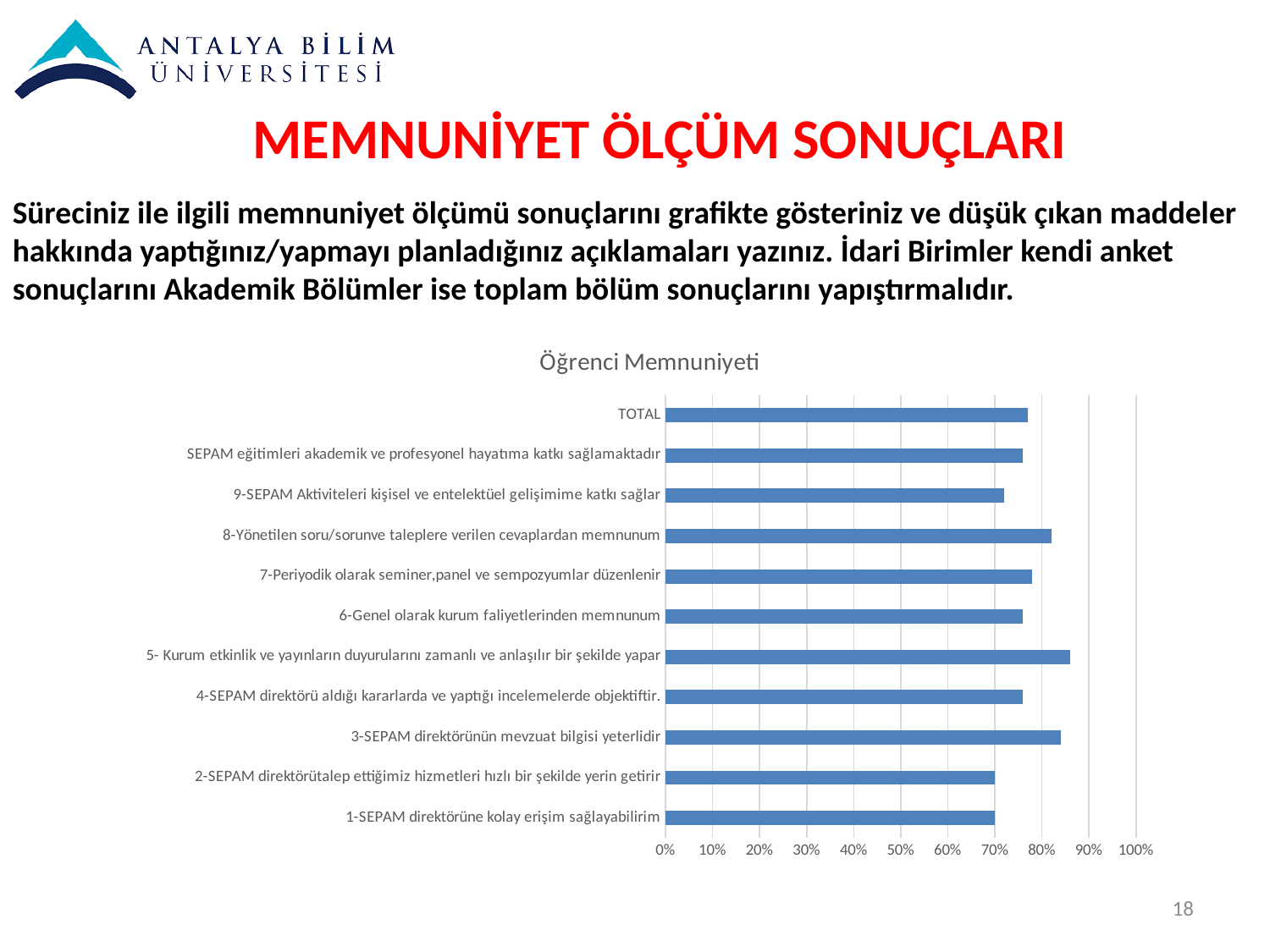
How many categories (bars) does the chart show? 11 Which has the larger value: "3-SEPAM direktörünün mevzuat bilgisi yeterlidir" or "1-SEPAM direktörüne kolay erişim sağlayabilirim"? 3-SEPAM direktörünün mevzuat bilgisi yeterlidir Is the value for "5- Kurum etkinlik ve yayınların duyurularını zamanlı ve anlaşılır bir şekilde yapar" greater or less than 80%? greater Is the value for "6-Genel olarak kurum faliyetlerinden memnunum" greater or less than 70%? greater Is the value for TOTAL greater or less than 90%? less Which has the larger value: "5- Kurum etkinlik ve yayınların duyurularını zamanlı ve anlaşılır bir şekilde yapar" or "9-SEPAM Aktiviteleri kişisel ve entelektüel gelişimime katkı sağlar"? 5- Kurum etkinlik ve yayınların duyurularını zamanlı ve anlaşılır bir şekilde yapar What colour are the bars in the chart? blue What is the title of the chart? Öğrenci Memnuniyeti What kind of chart is shown on the slide? bar chart